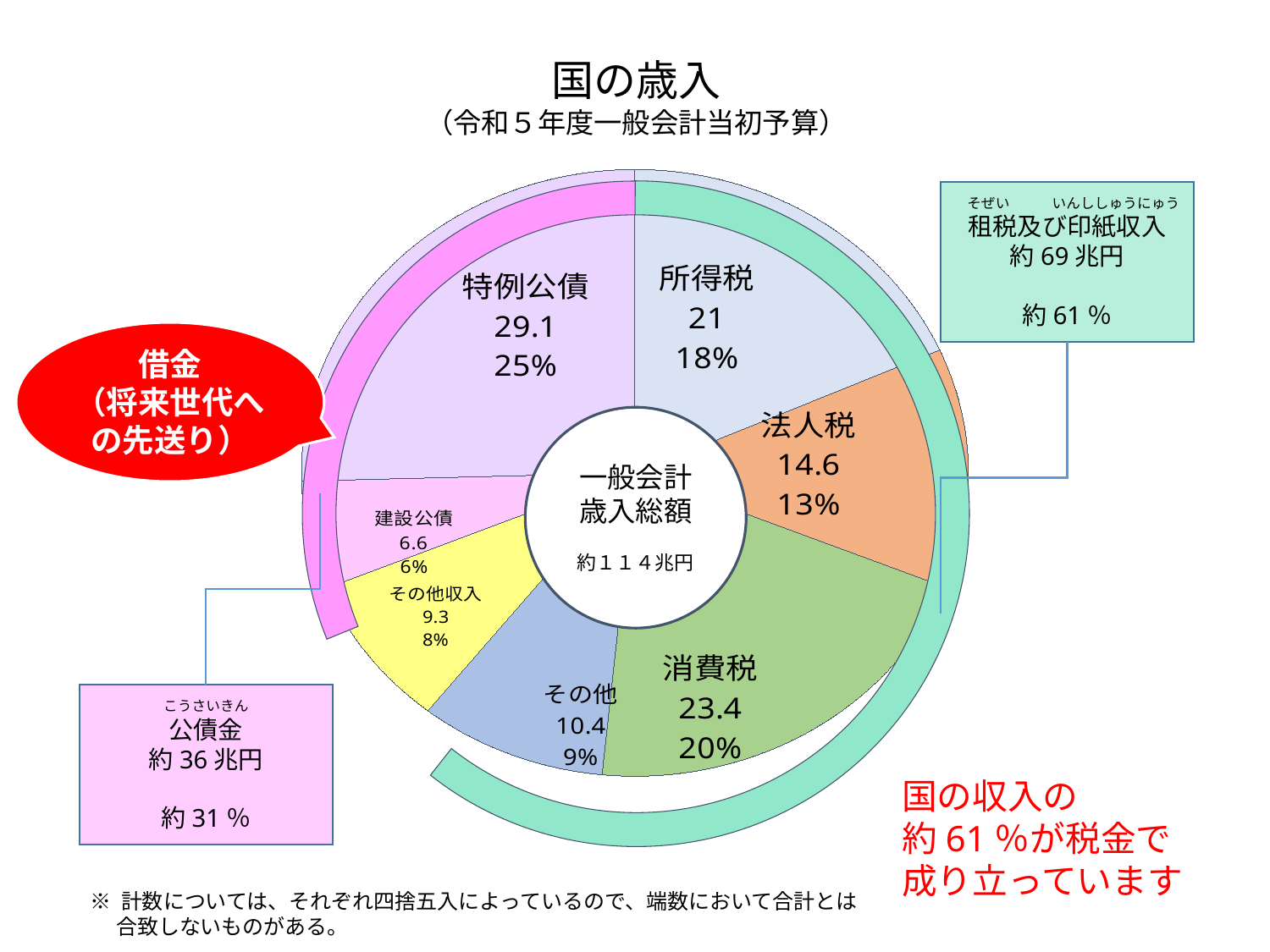
What is the value shown for 所得税 in the pie chart? 21 What is the value shown for 建設公債 in the pie chart? 6.6 What percentage share of the pie does 消費税 represent? 20% How many slices does the pie chart have? 7 What total amount is shown in the centre of the pie chart? 約１１４兆円 What kind of chart is shown on the slide? pie chart What is the value shown for 消費税 in the pie chart? 23.4 What is the difference between the values for 消費税 and 所得税? 2.4 Which is larger, the value for 法人税 or the value for その他? 法人税 What is the difference between the values for 特例公債 and 消費税? 5.7 Which slice of the pie chart has the smallest value? 建設公債 Which slice of the pie chart has the largest value? 特例公債